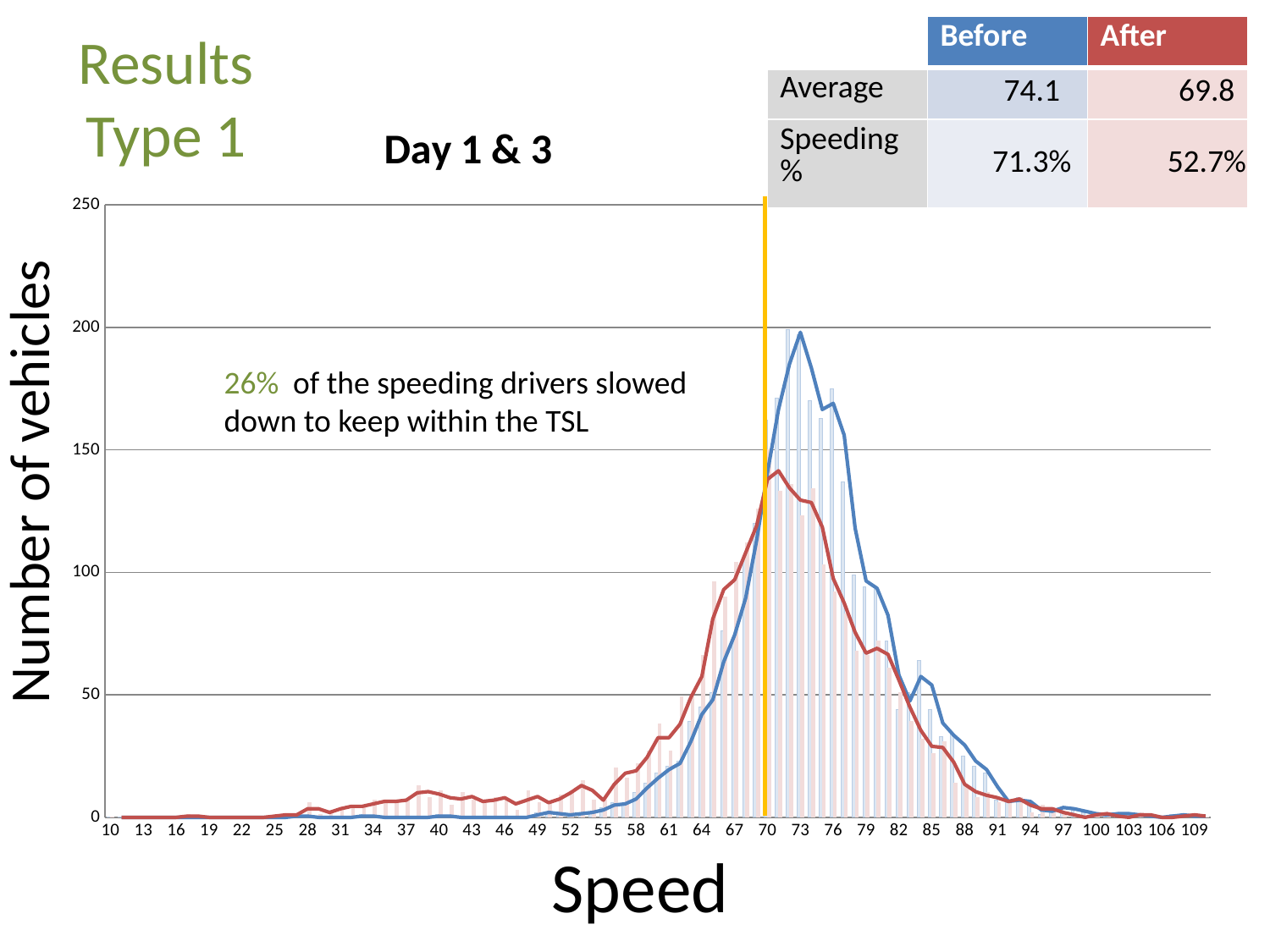
Does the blue (Before) line rise or fall as speed increases from 73 to 91? fall What is the label of the vertical axis of the chart? Number of vehicles What is the title of the chart? Day 1 & 3 What is the highest value shown on the vertical axis of the chart? 250 Which line reaches the higher peak, the blue (Before) line or the red (After) line? blue (Before) Is the peak value of the blue (Before) line greater or less than 150? greater Does the red (After) line rise or fall as speed increases from 55 to 70? rise Is the value of the red (After) line at a speed of 40 greater or less than 50? less Is the peak value of the red (After) line greater or less than 100? greater At a speed of 79, which line is higher, the blue (Before) line or the red (After) line? blue (Before) At a speed of 64, which line is higher, the blue (Before) line or the red (After) line? red (After)